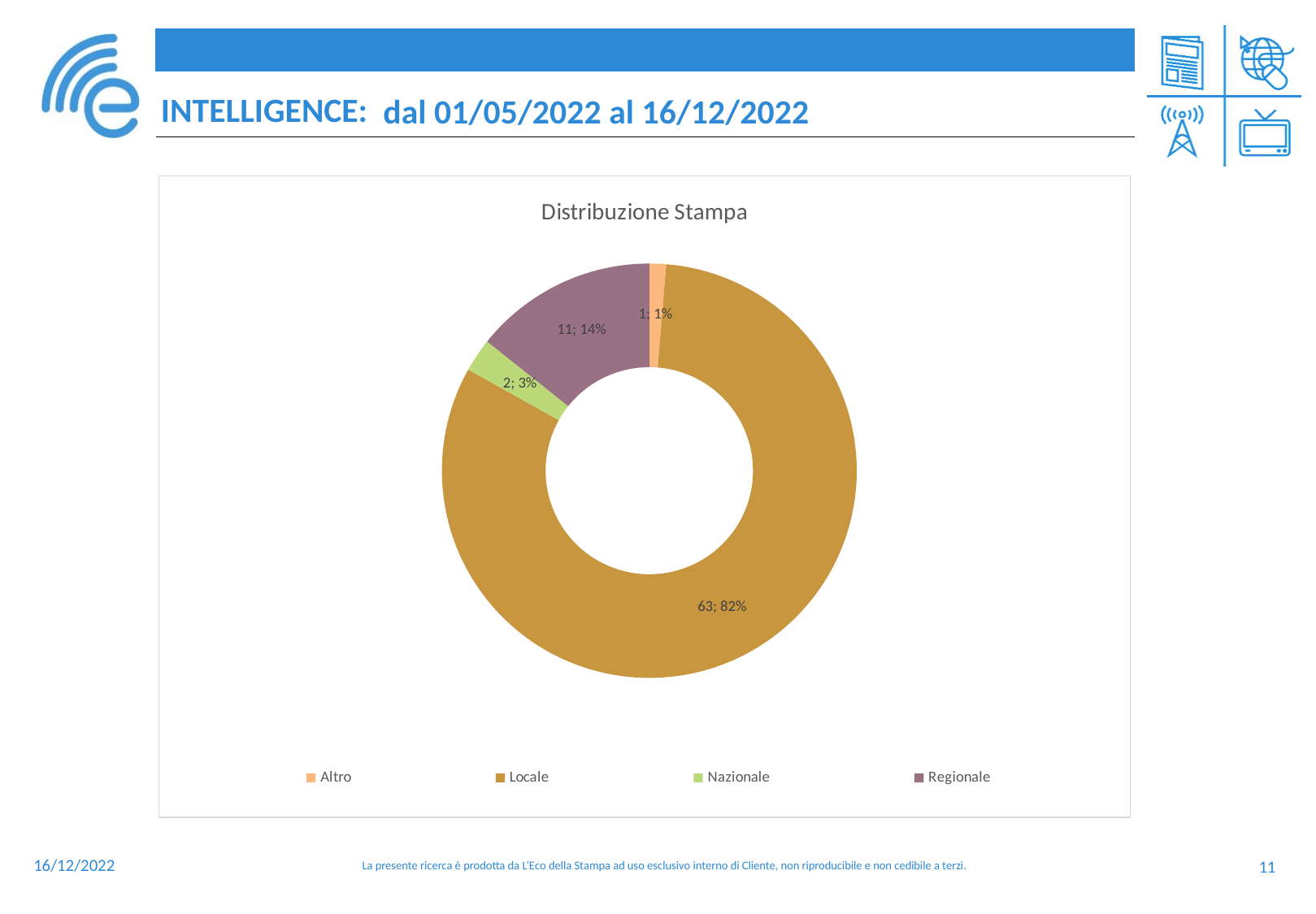
What is the value for Locale? 63 What share of the chart does Regionale represent? 14% What is the value for Altro? 1 Which category has the smallest slice? Altro What is the value for Nazionale? 2 What is the difference between the values for Locale and Regionale? 52 What kind of chart is shown on the slide? Doughnut (pie) chart Which category has the largest slice? Locale How many categories does the legend list? 4 What is the title of the chart? Distribuzione Stampa What share of the chart does Locale represent? 82% What is the value for Regionale? 11